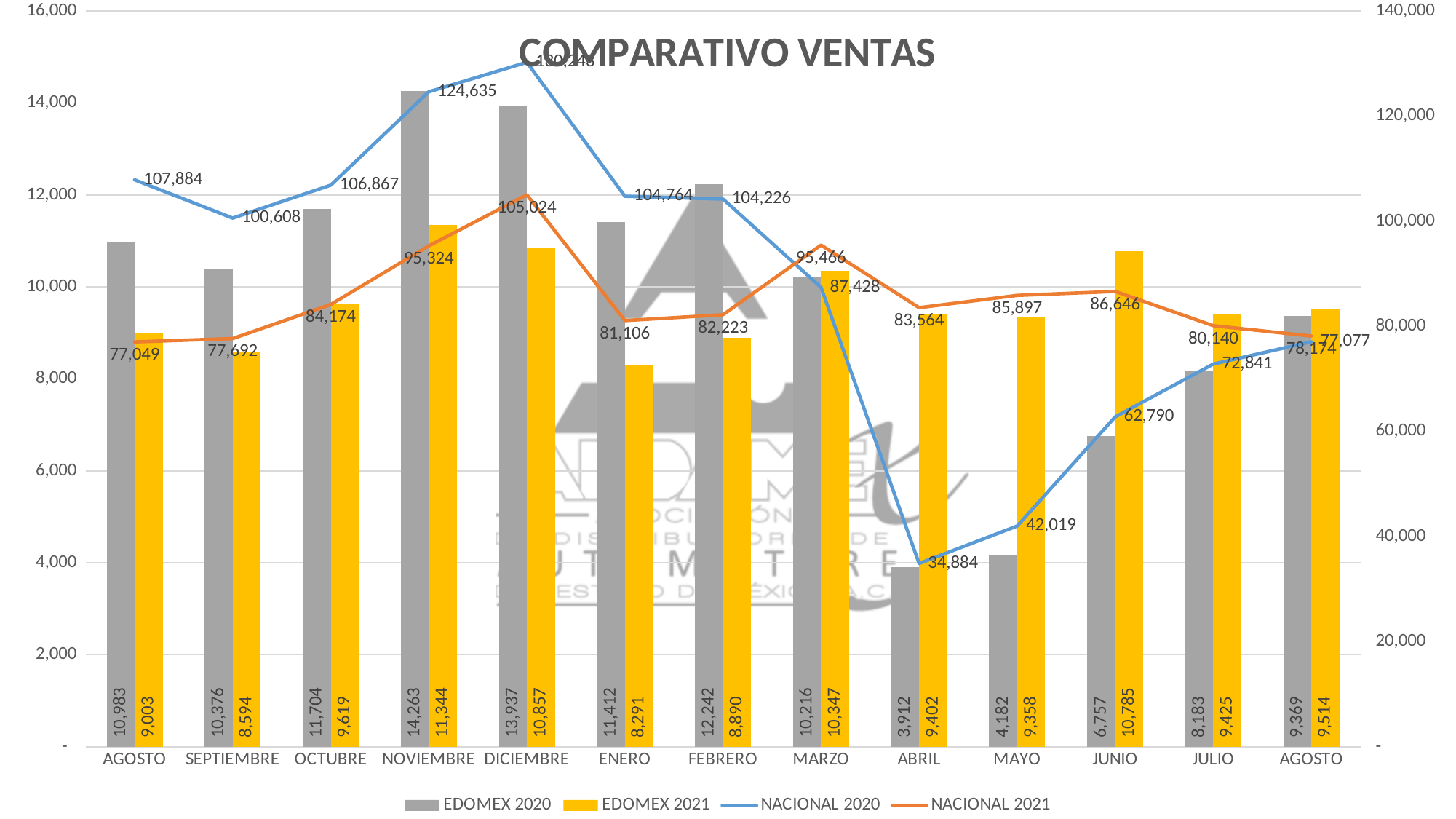
What kind of chart is this? Combination bar and line chart What is the value of EDOMEX 2020 for NOVIEMBRE? 14,263 In MARZO, which is larger, EDOMEX 2020 or EDOMEX 2021? EDOMEX 2021 In which month is NACIONAL 2020 lowest? ABRIL What is the difference between EDOMEX 2021 and EDOMEX 2020 in ABRIL? 5,490 In which month is EDOMEX 2021 lowest? ENERO What is the value of NACIONAL 2020 for MAYO? 42,019 How many months are shown on the x axis? 13 In which month is EDOMEX 2020 highest? NOVIEMBRE What is the value of NACIONAL 2021 for DICIEMBRE? 105,024 How many series does the legend list? 4 What is the value of EDOMEX 2021 for JUNIO? 10,785